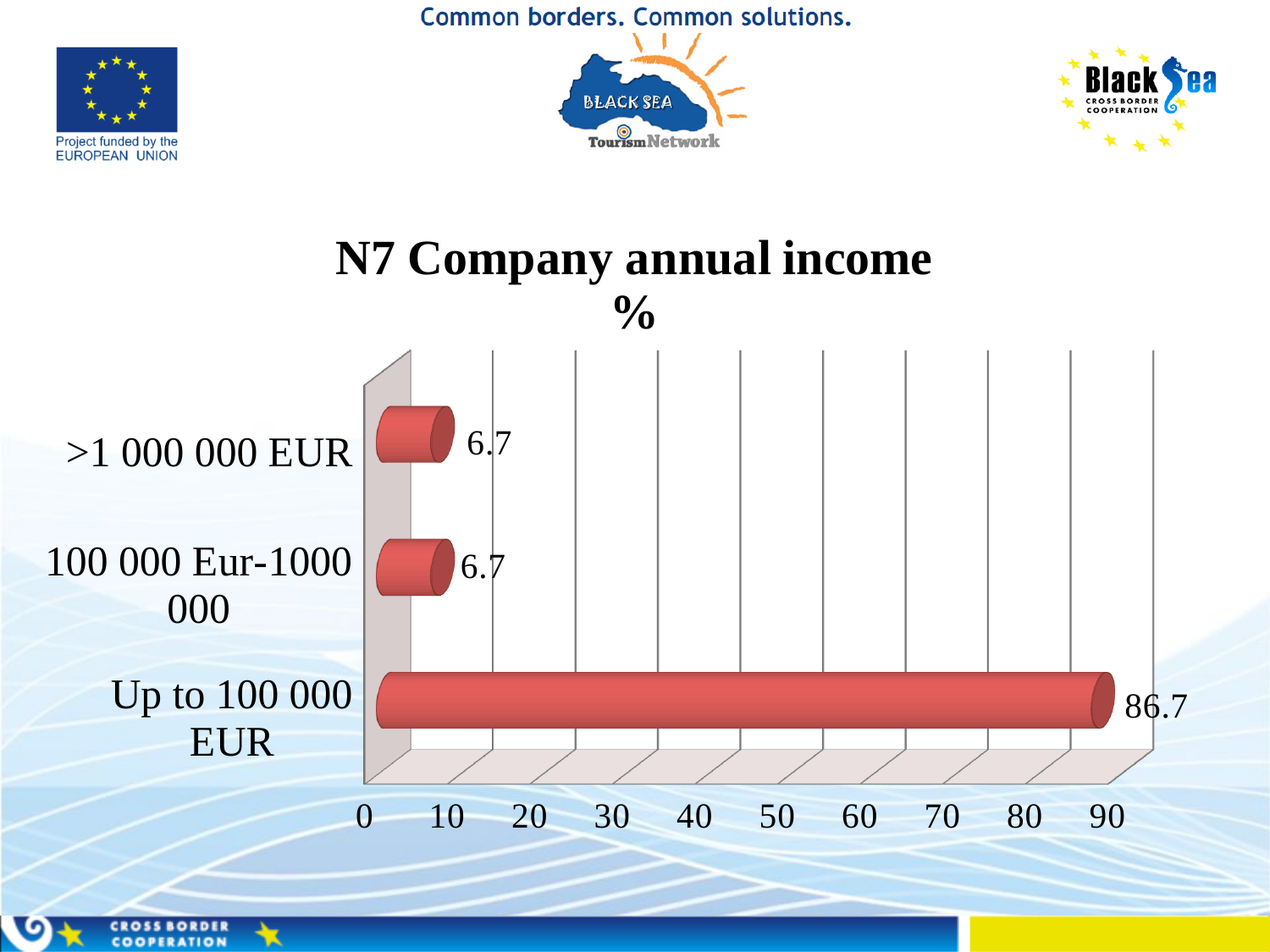
Which is larger, the value for 'Up to 100 000 EUR' or the value for '100 000 Eur-1000 000'? Up to 100 000 EUR What is the value for 'Up to 100 000 EUR'? 86.7 How many categories are shown in the chart? 3 Is the value for 'Up to 100 000 EUR' greater or less than 80? greater What is the title of the chart? N7 Company annual income % What is the value for '100 000 Eur-1000 000'? 6.7 What is the highest tick value shown on the horizontal axis? 90 What is the value for '>1 000 000 EUR'? 6.7 Which category has the highest value? Up to 100 000 EUR Is the value for '>1 000 000 EUR' greater or less than 10? less What is the difference between the values for 'Up to 100 000 EUR' and '>1 000 000 EUR'? 80 What kind of chart is shown on the slide? bar chart